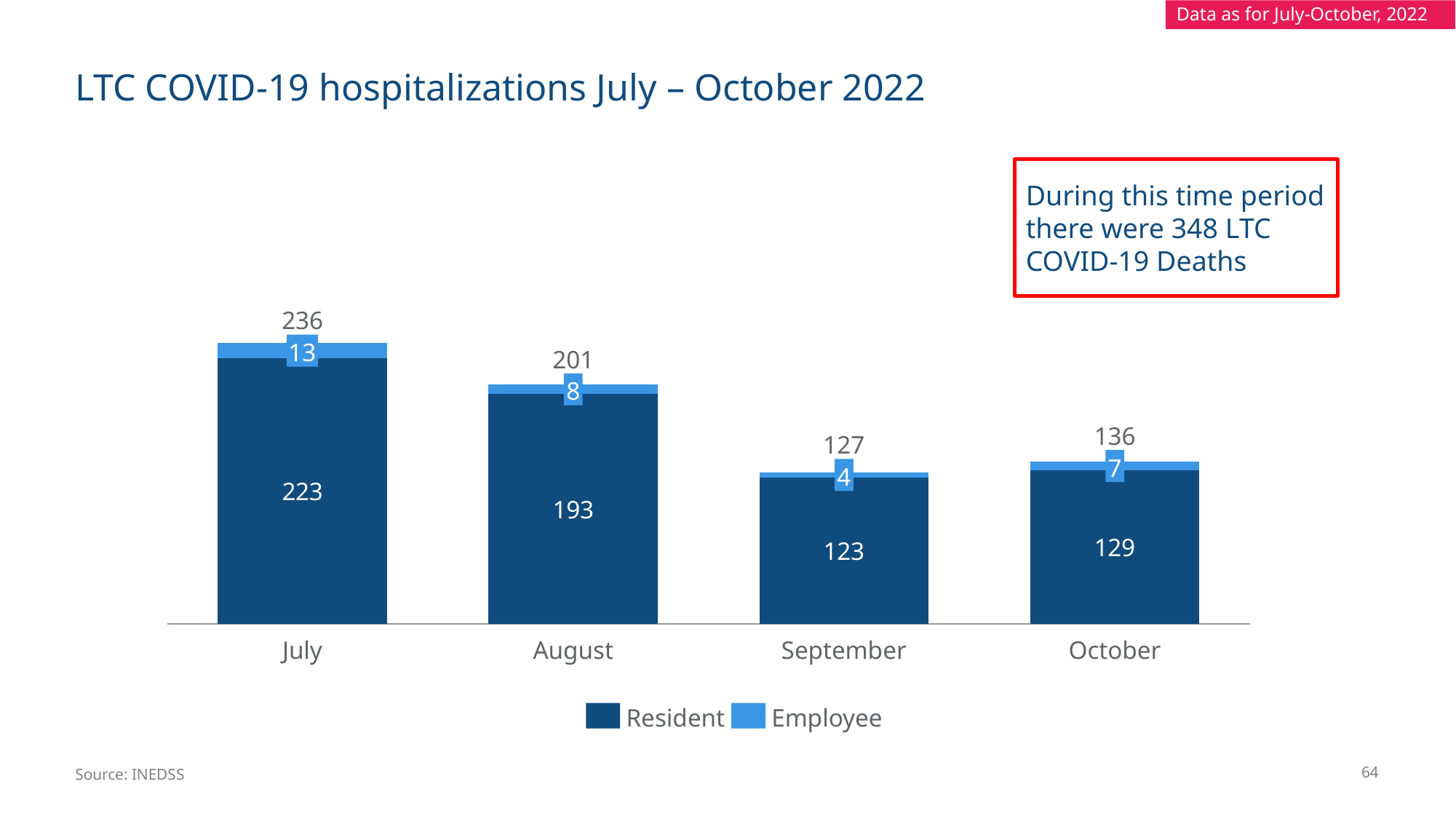
Which is larger, the Employee value for October or the Employee value for August? October How many months are shown on the x axis? 4 What is the title of the chart? LTC COVID-19 hospitalizations July – October 2022 Which month has the lowest Resident value? September What is the Employee value for September? 4 What is the total of the stacked bar for August? 201 How many series does the legend list? 2 What is the Resident value for July? 223 Do the total hospitalizations rise or fall from July to September? Fall Which month has the highest total hospitalizations? July What kind of chart is shown on the slide? Stacked bar chart What is the difference between the Resident values for July and August? 30